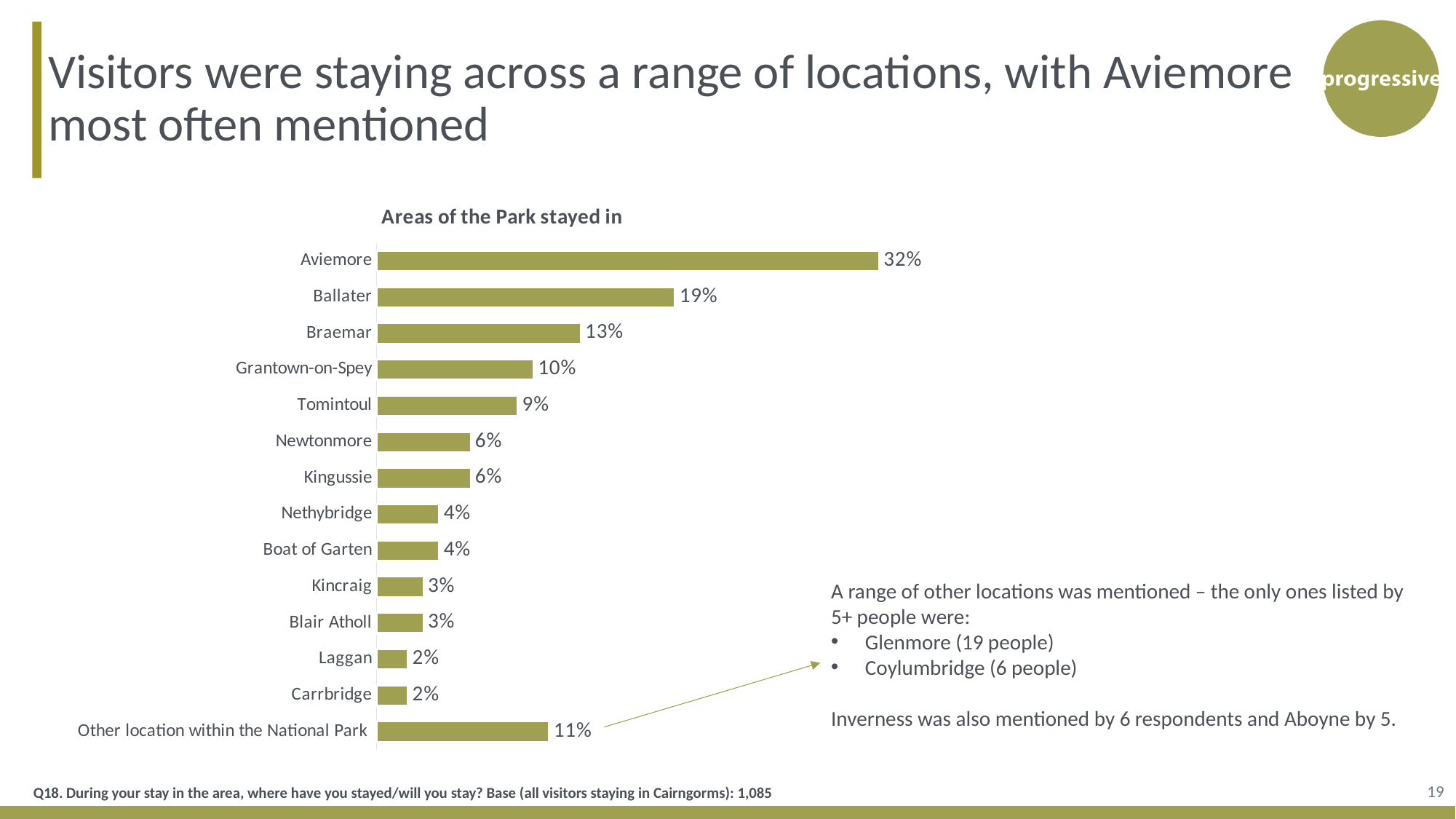
Which has a higher value, Ballater or Braemar? Ballater What is the difference in percentage points between Aviemore and Ballater? 13 How many categories are shown in the chart? 14 What is the difference in percentage points between Braemar and Tomintoul? 4 What type of chart is used to show the areas of the Park stayed in? Bar chart What is the value shown for Laggan? 2% What is the value shown for Grantown-on-Spey? 10% What is the title of the chart? Areas of the Park stayed in Which has a higher value, Newtonmore or Nethybridge? Newtonmore What percentage of visitors stayed in Aviemore? 32% What percentage is shown for Other location within the National Park? 11% Which area has the highest percentage of visitors staying in it? Aviemore